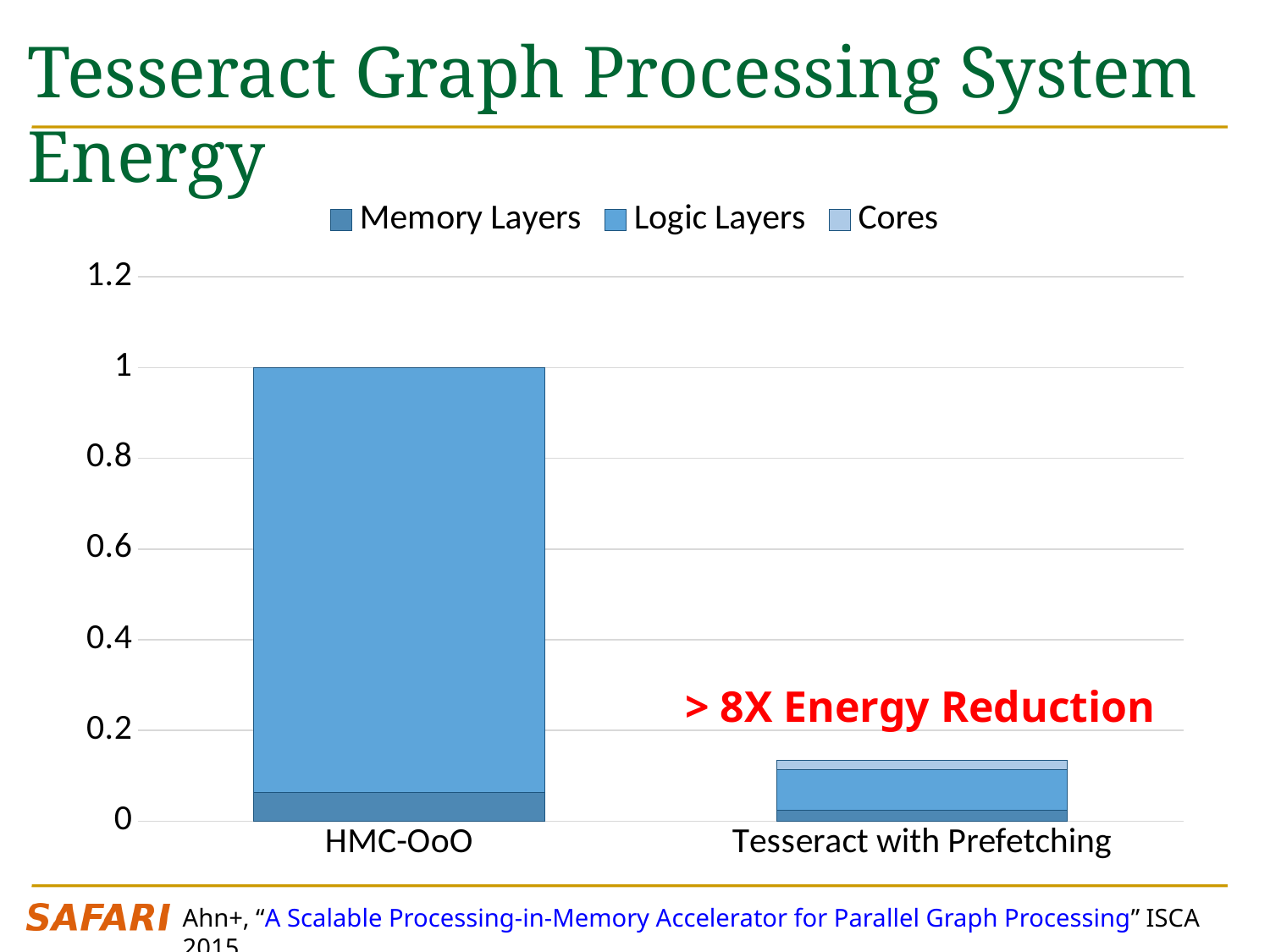
How many series does the legend list? 3 Is the total value for Tesseract with Prefetching greater or less than 0.2? less What kind of chart is shown on the slide? bar chart Which category has the highest total energy? HMC-OoO Which category has the lowest total energy? Tesseract with Prefetching What does the red annotation on the chart say? > 8X Energy Reduction What are the three series listed in the legend? Memory Layers, Logic Layers, Cores Which has a larger total bar, HMC-OoO or Tesseract with Prefetching? HMC-OoO What is the total height of the stacked bar for HMC-OoO? 1 Is the Memory Layers value for HMC-OoO greater or less than 0.2? less Do the total bar values rise or fall from left to right along the x axis? fall How many categories are shown on the x axis? 2